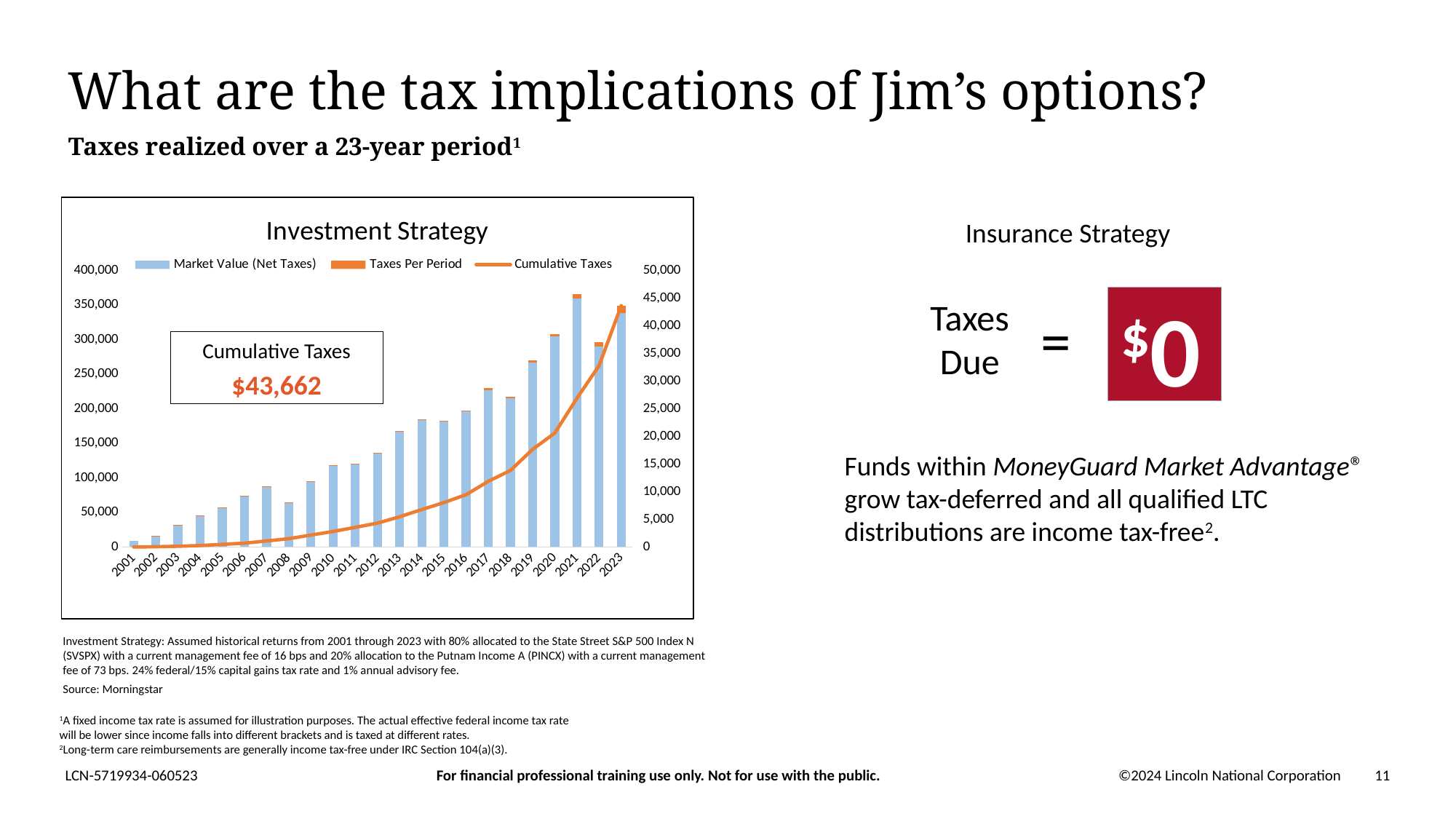
What is the title of the chart on the slide? Investment Strategy Does the Cumulative Taxes line in the Investment Strategy chart generally rise or fall from 2001 to 2023? rise How many years are shown on the x axis of the Investment Strategy chart? 23 In which year is the Market Value (Net Taxes) bar lowest in the Investment Strategy chart? 2001 What is the total Cumulative Taxes value printed on the Investment Strategy chart? $43,662 In the Investment Strategy chart, is the Market Value (Net Taxes) for 2010 greater or less than 100,000? greater In the Investment Strategy chart, is the Market Value (Net Taxes) for 2005 greater or less than 100,000? less In which year is the Market Value (Net Taxes) bar highest in the Investment Strategy chart? 2021 In the Investment Strategy chart, is the Market Value (Net Taxes) bar larger in 2021 or in 2023? 2021 How many series does the legend of the Investment Strategy chart list? 3 In the Investment Strategy chart, is the Market Value (Net Taxes) bar larger in 2019 or in 2020? 2020 What kind of chart is the Investment Strategy chart? bar chart with a line